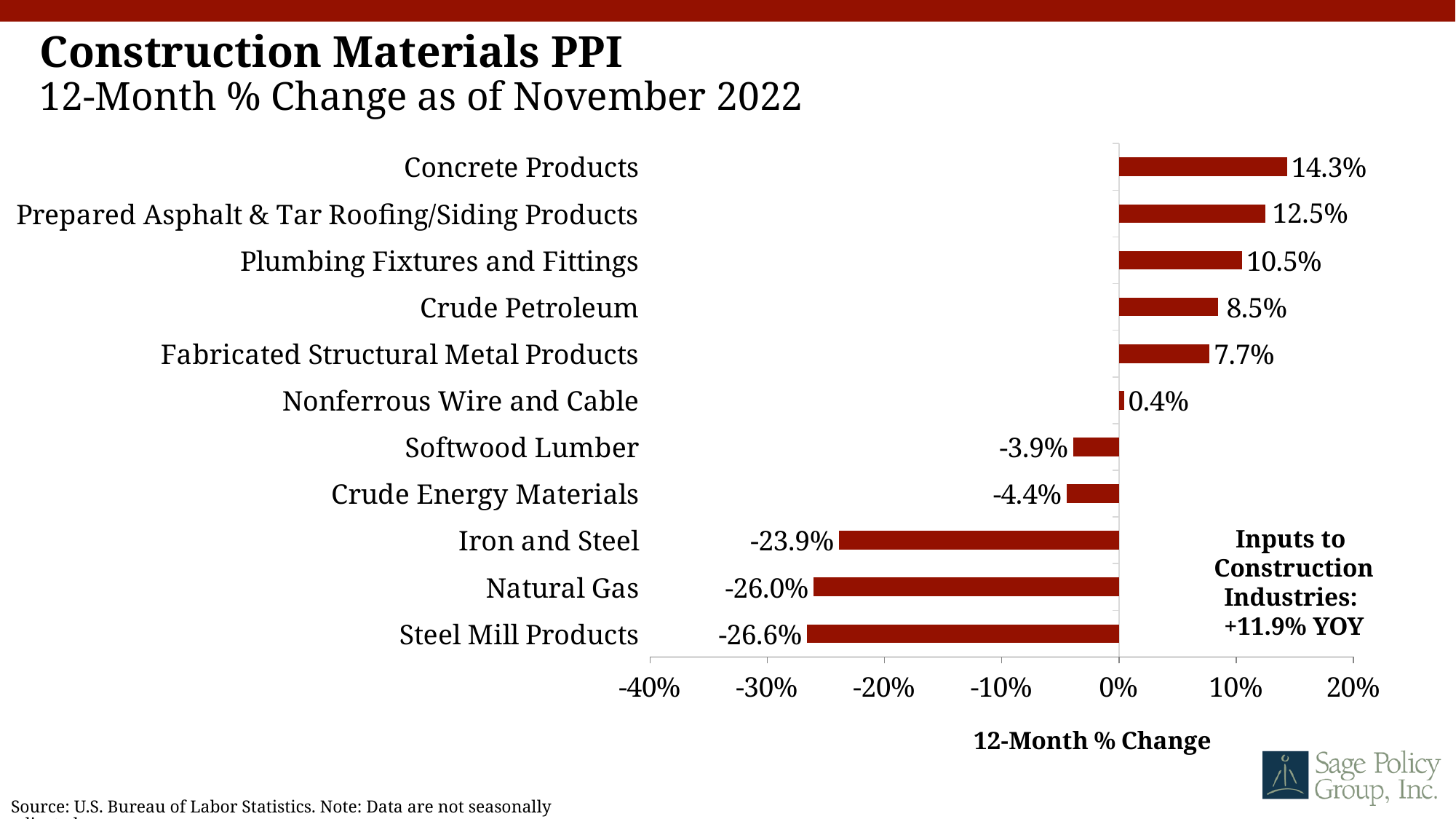
How many categories are shown in the chart? 11 What kind of chart is shown on the slide? Bar chart What is the 12-month % change for Natural Gas? -26.0% What is the difference between the 12-month % change for Concrete Products and Plumbing Fixtures and Fittings? 3.8 percentage points What is the label of the x axis? 12-Month % Change What is the 12-month % change for Nonferrous Wire and Cable? 0.4% Which category has the highest 12-month % change? Concrete Products Is the value for Iron and Steel greater or less than -20%? less What is the 12-month % change for Concrete Products? 14.3% Which category has the lowest 12-month % change? Steel Mill Products Which has a larger 12-month % change, Crude Petroleum or Fabricated Structural Metal Products? Crude Petroleum What is the 12-month % change for Inputs to Construction Industries noted on the chart? +11.9% YOY